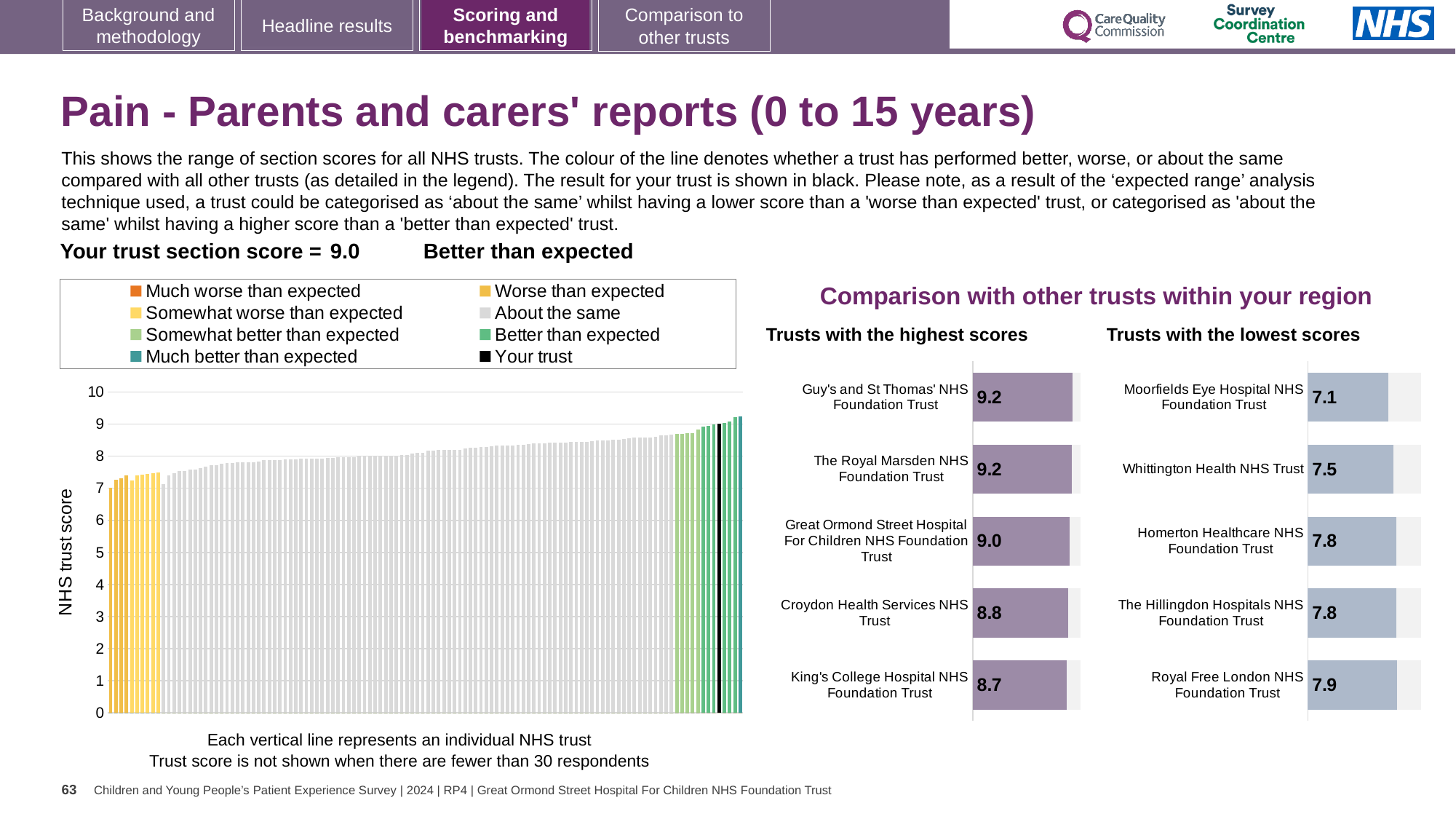
In the main NHS trust score chart, what colour is used for 'Your trust'? black In the 'Trusts with the highest scores' chart, which trust has the lowest score? King's College Hospital NHS Foundation Trust How many trusts are listed in the 'Trusts with the highest scores' chart? 5 In the 'Trusts with the lowest scores' chart, how much higher is Royal Free London NHS Foundation Trust's score than Moorfields Eye Hospital NHS Foundation Trust's? 0.8 In the 'Trusts with the lowest scores' chart, which trust has the highest score? Royal Free London NHS Foundation Trust In the 'Trusts with the lowest scores' chart, which has the higher score: Whittington Health NHS Trust or Homerton Healthcare NHS Foundation Trust? Homerton Healthcare NHS Foundation Trust In the 'Trusts with the highest scores' chart, what is the score for Croydon Health Services NHS Trust? 8.8 In the 'Trusts with the highest scores' chart, what is the difference between the scores of Guy's and St Thomas' NHS Foundation Trust and King's College Hospital NHS Foundation Trust? 0.5 How many entries does the legend of the main NHS trust score chart list? 8 In the main NHS trust score chart, do the values rise or fall from left to right? rise What kind of chart is the main chart on the left showing NHS trust scores? bar chart In the 'Trusts with the lowest scores' chart, what is the score for Moorfields Eye Hospital NHS Foundation Trust? 7.1